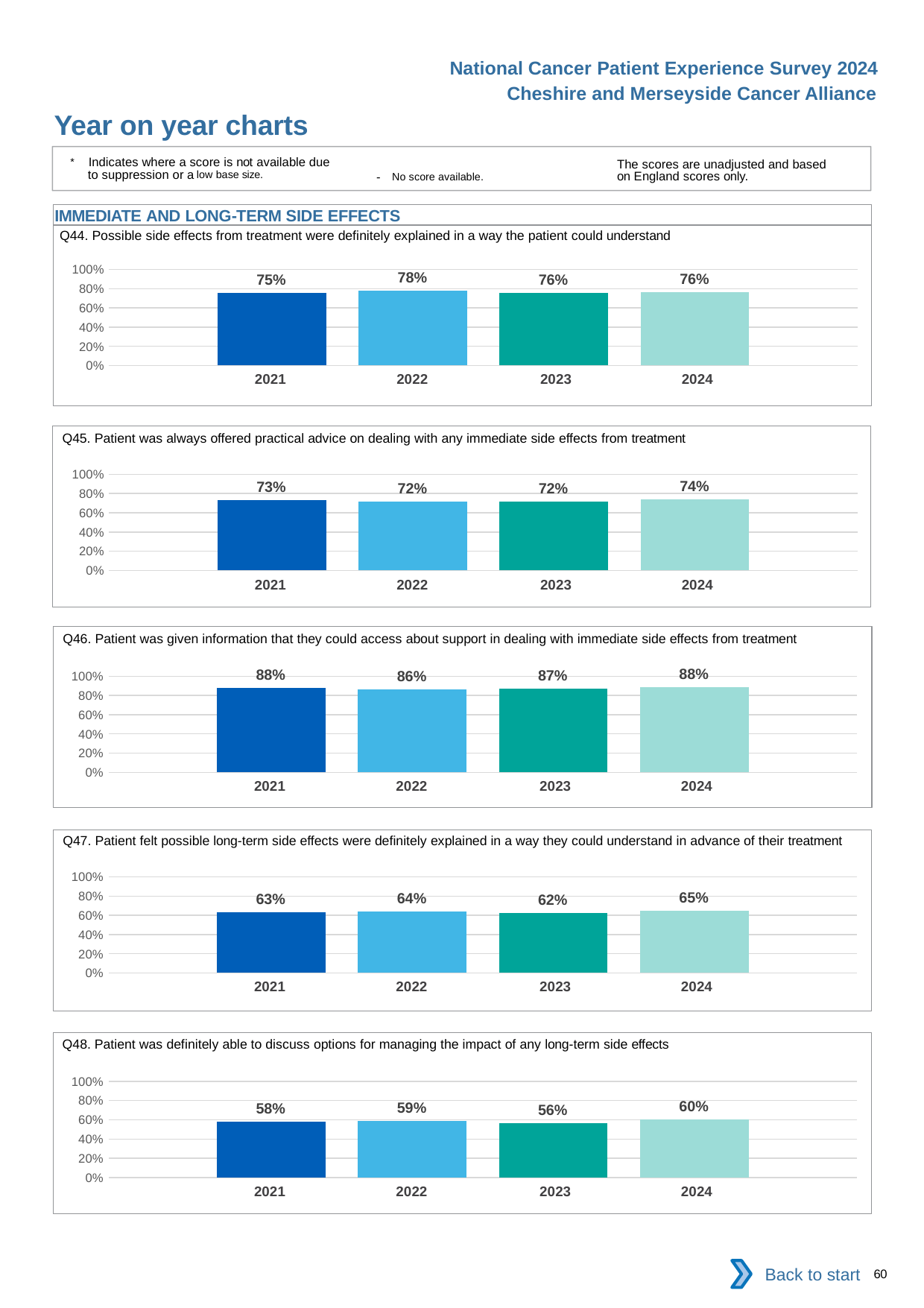
In the Q48 chart, is the value for 2023 greater or less than 60%? less In the Q44 chart, what is the value for 2022? 78% In the Q45 chart, what is the value for 2024? 74% In the Q48 chart, what is the value for 2021? 58% In the Q44 chart, which year has the highest value? 2022 In the Q45 chart, what is the difference between the 2024 value and the 2022 value? 2% What kind of chart is the Q48 chart? Bar chart In the Q47 chart, what is the value for 2023? 62% In the Q48 chart, what is the difference between the 2024 value and the 2023 value? 4% In the Q47 chart, which is larger, the value for 2021 or the value for 2024? 2024 In the Q46 chart, how many years are shown on the x axis? 4 In the Q46 chart, which year has the lowest value? 2022